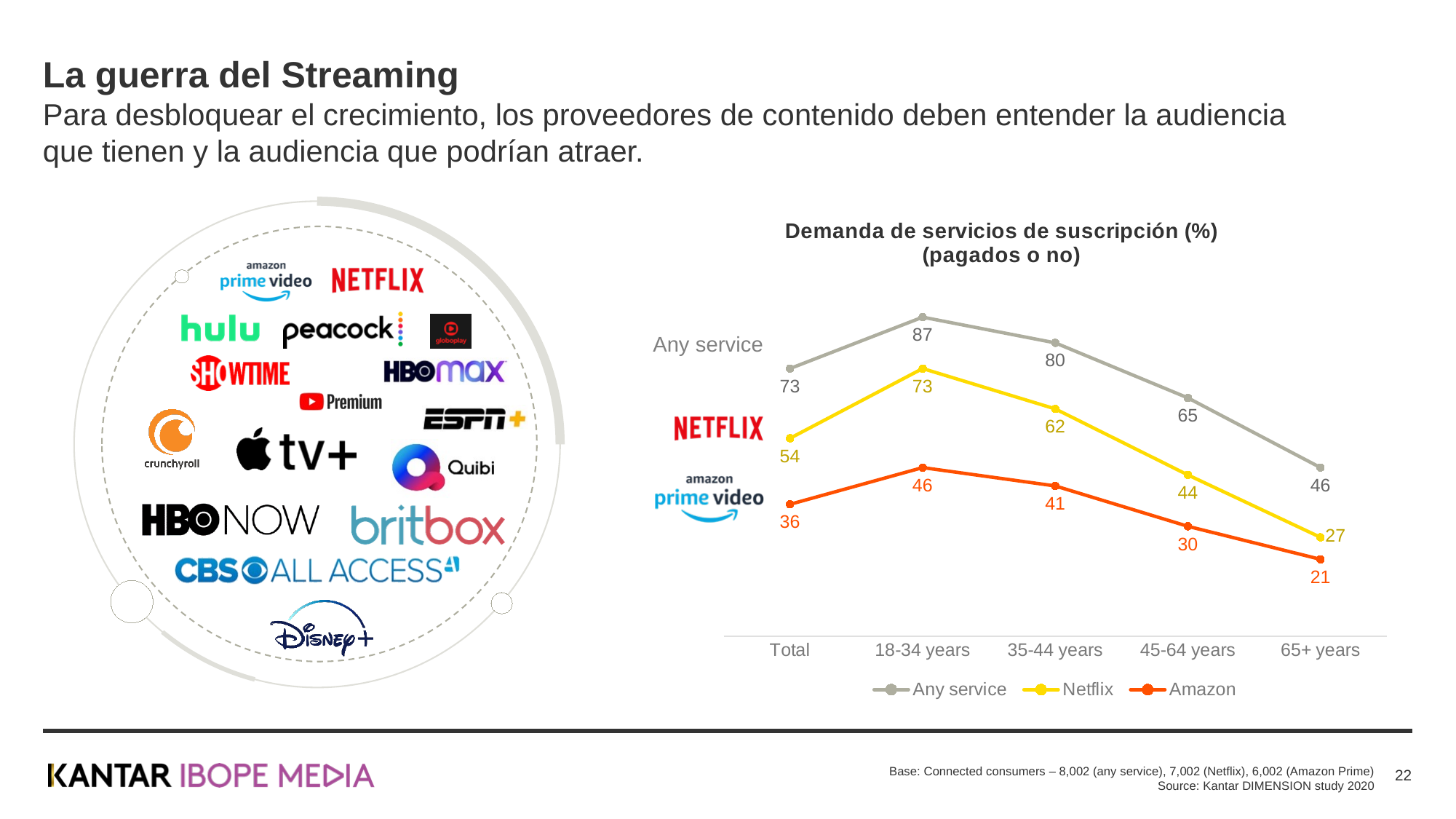
How many series does the legend list? 3 From 18-34 years to 65+ years, do the values for Amazon rise or fall? Fall How many categories are shown on the x axis? 5 Which is larger in the 45-64 years category: Netflix or Amazon? Netflix What is the value for Any service in the Total category? 73 What is the title of the chart? Demanda de servicios de suscripción (%) (pagados o no) What is the value for Amazon in the 65+ years category? 21 What is the difference between Any service and Amazon in the 35-44 years category? 39 Which age category has the highest value for Any service? 18-34 years Which category has the lowest value for Netflix? 65+ years What is the value for Netflix in the 18-34 years category? 73 What kind of chart is shown on the slide? Line chart